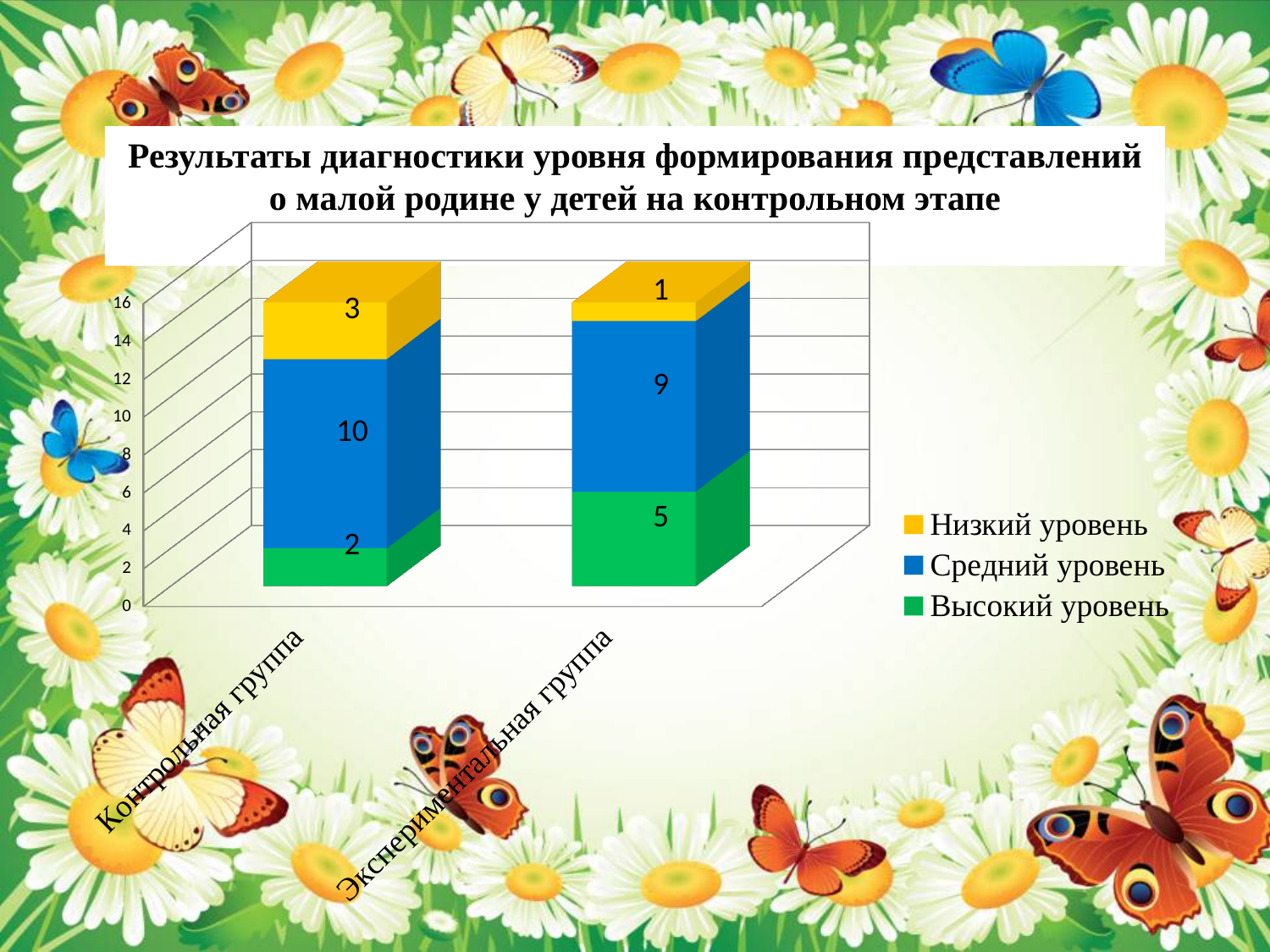
What is the total of the stacked bar for the Контрольная группа? 15 What kind of chart is shown on the slide? Stacked bar chart What is the difference between the Высокий уровень values of the Экспериментальная группа and the Контрольная группа? 3 Which group has the higher value for Высокий уровень? Экспериментальная группа How many groups (categories) are shown on the x axis? 2 What is the value for Высокий уровень in the Экспериментальная группа? 5 What is the difference between the Средний уровень values of the Контрольная группа and the Экспериментальная группа? 1 What is the value for Средний уровень in the Контрольная группа? 10 How many series does the legend list? 3 What is the value for Низкий уровень in the Экспериментальная группа? 1 What is the total of the stacked bar for the Экспериментальная группа? 15 What is the value for Низкий уровень in the Контрольная группа? 3